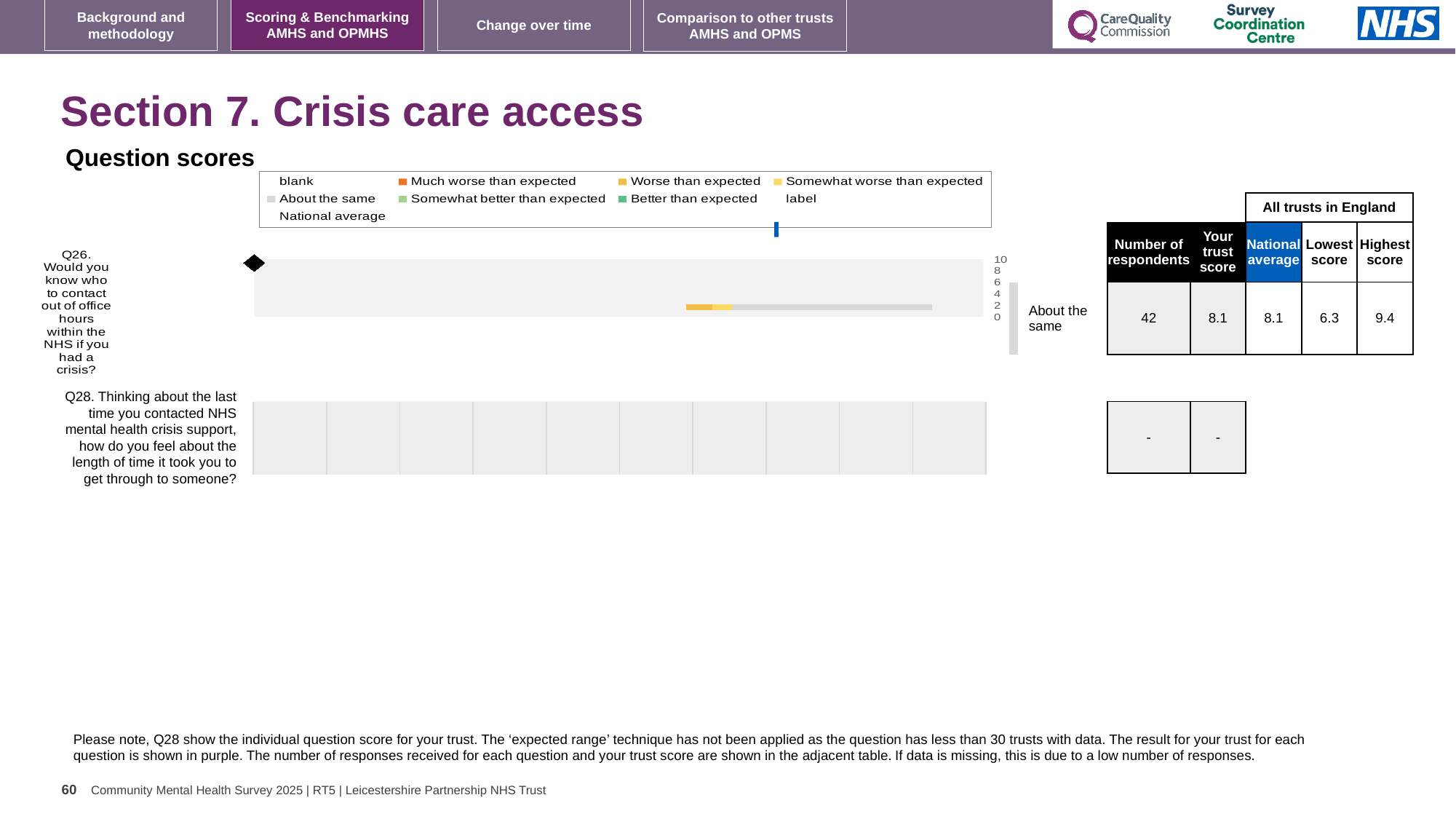
How many respondents answered Q26? 42 What kind of chart is used to show the question scores on this slide? bar chart What is the national average for Q26? 8.1 How many questions are plotted in the question scores chart? 2 What is the lowest score among all trusts in England for Q26? 6.3 Is the trust score for Q26 higher than, lower than, or the same as the national average? the same What is shown as the trust score for Q28 in the table? - What category label is shown beside the Q26 bar? About the same What colour represents 'Much worse than expected' in the legend? orange What is the highest score among all trusts in England for Q26? 9.4 What is the difference between the highest score and the lowest score for Q26? 3.1 What is the trust score for Q26 shown in the table next to the chart? 8.1